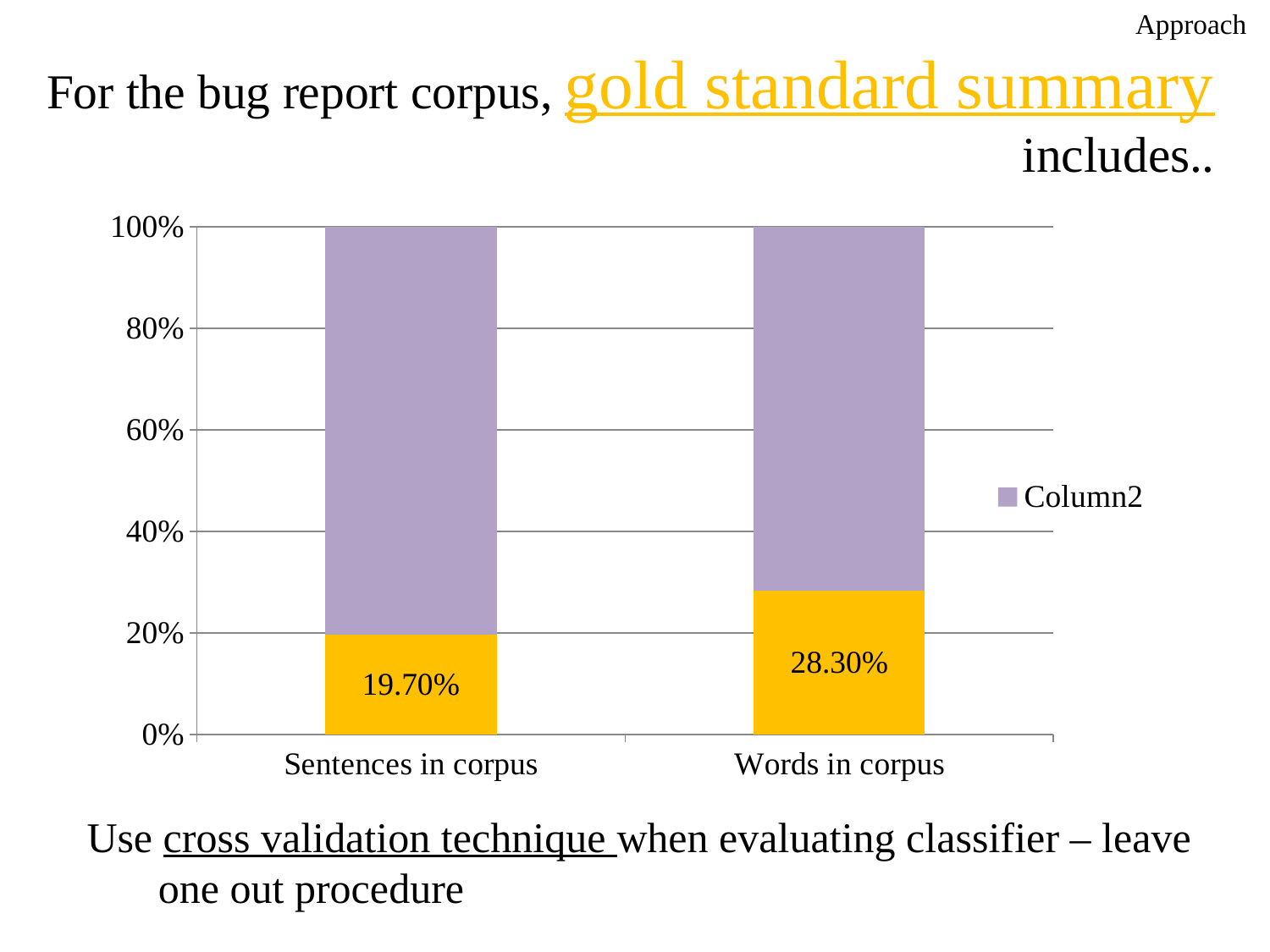
How many categories are shown on the x axis? 2 Which category has the lower labelled value? Sentences in corpus What is the name of the series listed in the legend? Column2 What is the labelled value for Words in corpus? 28.30% What kind of chart is shown on the slide? stacked bar chart How many series does the legend list? 1 What is the labelled value for Sentences in corpus? 19.70% Which category has the higher labelled value, Sentences in corpus or Words in corpus? Words in corpus Is the labelled value for Words in corpus greater or less than 40%? less Is the labelled value for Sentences in corpus greater or less than 20%? less Is the labelled value for Words in corpus larger or smaller than the labelled value for Sentences in corpus? larger What is the difference between the labelled values for Words in corpus and Sentences in corpus? 8.60%